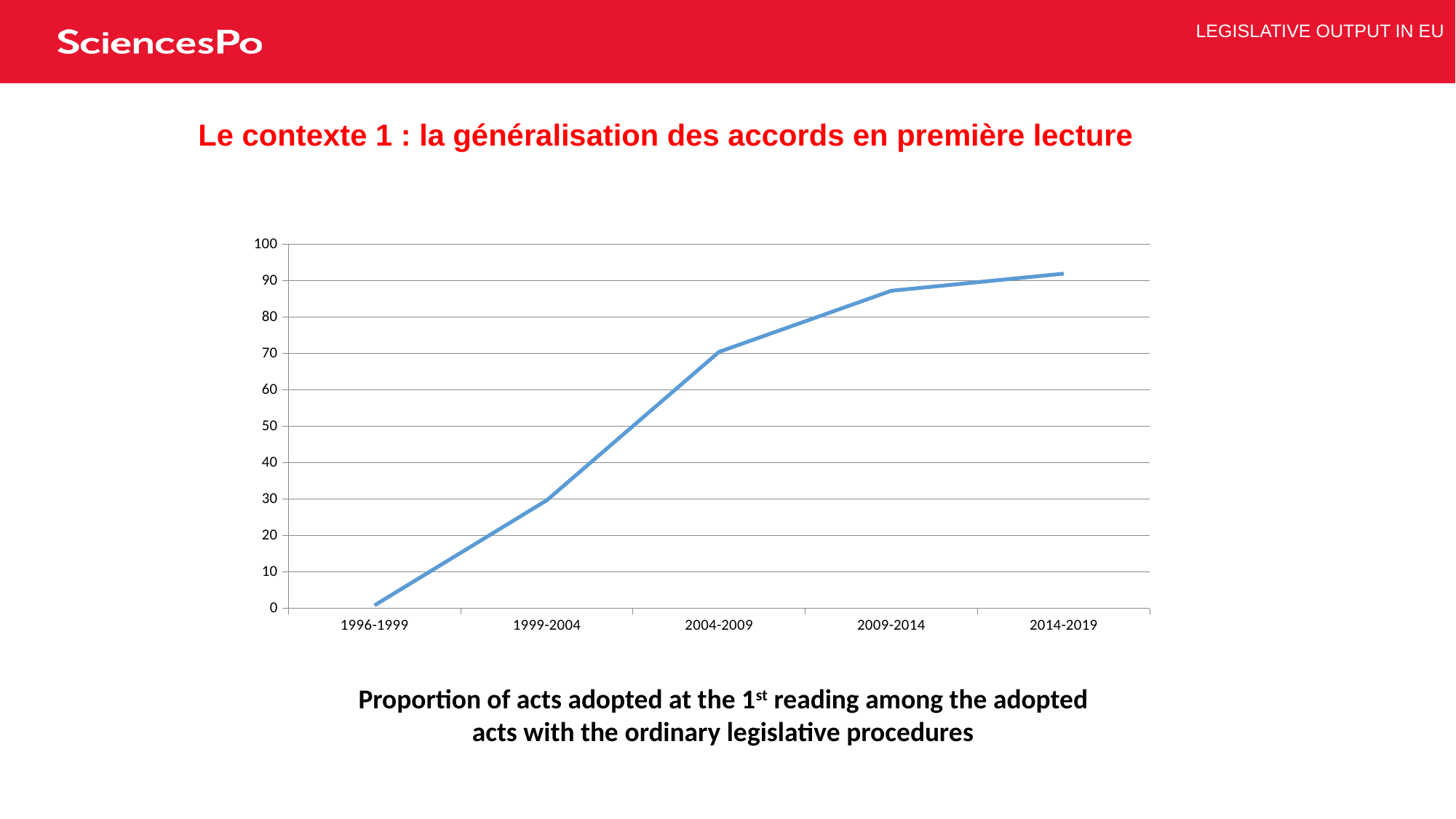
What is the caption below the chart describing what is plotted? Proportion of acts adopted at the 1st reading among the adopted acts with the ordinary legislative procedures Do the values rise or fall from 1996-1999 to 2014-2019? rise Is the value for 1996-1999 greater or less than 10? less What kind of chart is shown on the slide? line chart Which period has the lowest proportion of acts adopted at the 1st reading? 1996-1999 Is the value for 2004-2009 greater or less than 60? greater Is the value for 1999-2004 greater or less than 20? greater Which period has the highest proportion of acts adopted at the 1st reading? 2014-2019 Which is larger, the value for 1999-2004 or the value for 2004-2009? 2004-2009 How many periods are plotted along the x axis? 5